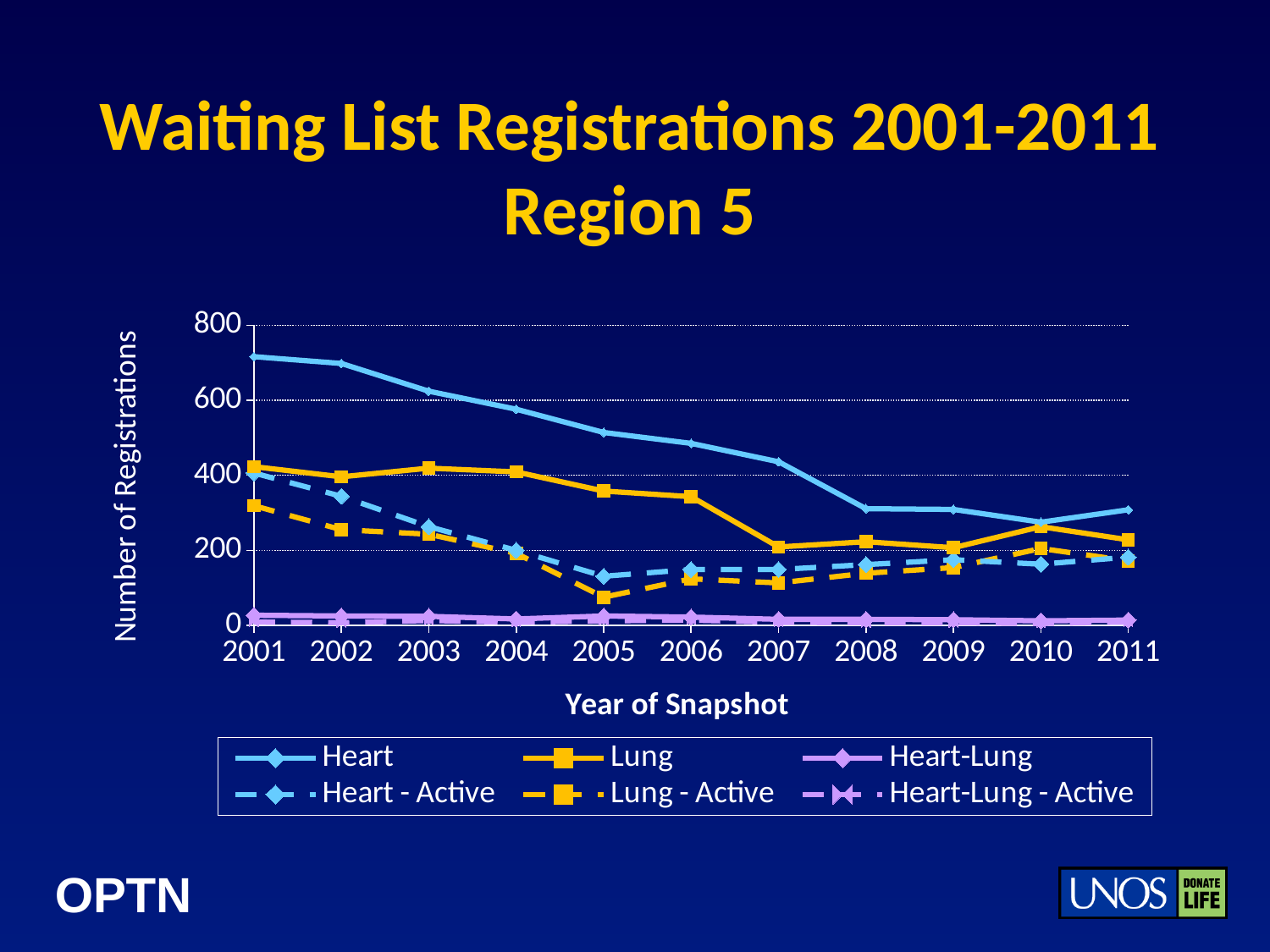
In 2005, which is larger: Heart - Active or Lung - Active? Heart - Active Does the Heart series rise or fall from 2001 to 2011? fall Is the value for Heart-Lung in 2005 greater or less than 200? less Is the value for Heart in 2001 greater or less than 600? greater What kind of chart is shown on the slide? line chart In 2001, which is larger: Heart or Lung? Heart How many years are plotted along the x axis? 11 What is the title of the y axis? Number of Registrations In which year is the Lung - Active series at its lowest? 2005 In which year is the Heart series at its highest? 2001 How many series does the legend list? 6 Is the value for Heart in 2011 greater or less than 200? greater